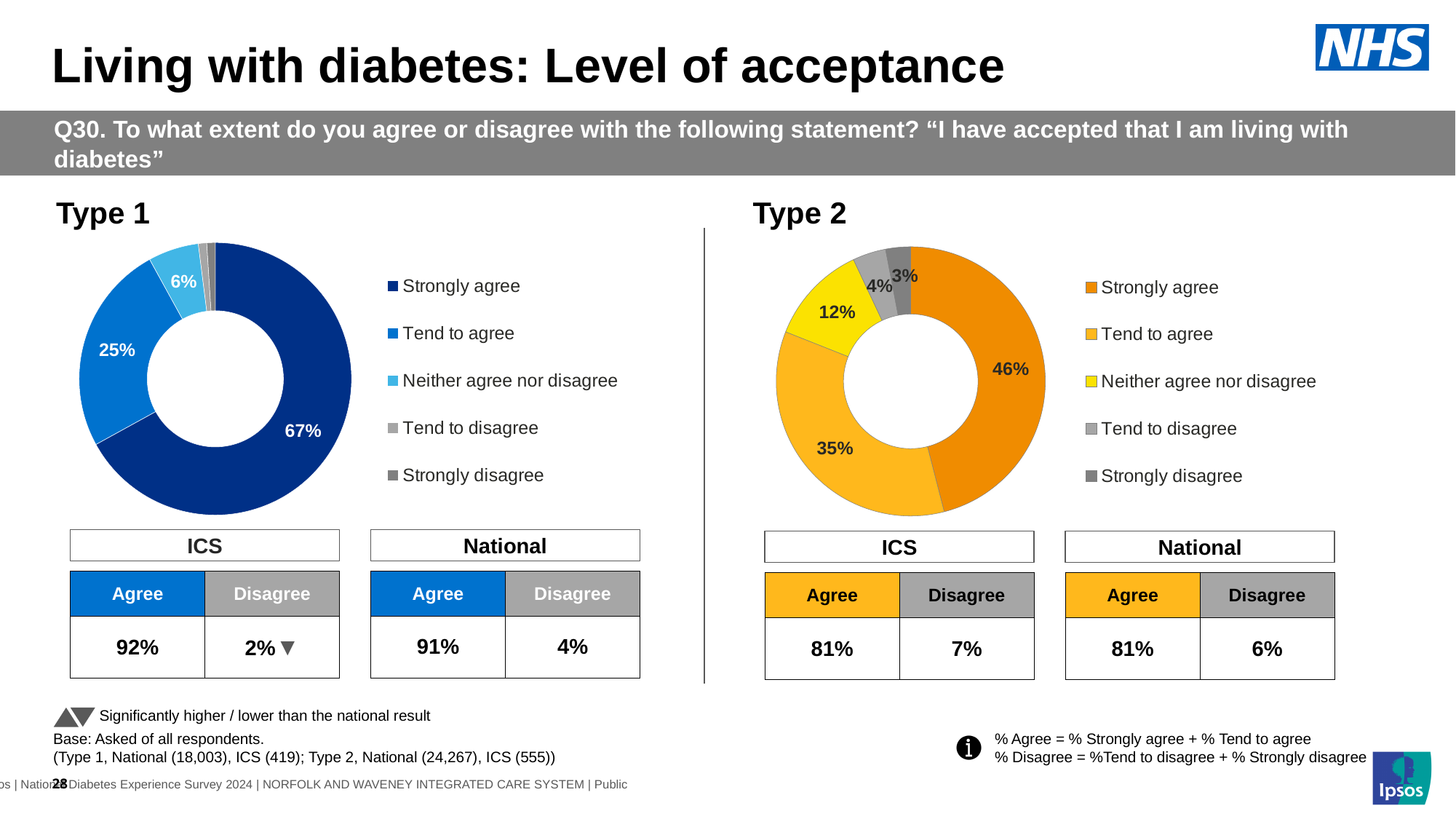
In the Type 1 chart, what is the difference between the Strongly agree and Tend to agree shares? 42 percentage points In the Type 1 chart, what colour represents Strongly agree? Dark blue In the Type 2 chart, which response category has the smallest share? Strongly disagree How many response categories does the legend of the Type 2 chart list? 5 In the Type 2 chart, what percentage of respondents neither agree nor disagree? 12% In the Type 2 chart, which response category has the largest share? Strongly agree In the Type 1 chart, what percentage of respondents tend to agree? 25% In the Type 2 chart, what is the difference between the Strongly agree and Tend to agree shares? 11 percentage points In the Type 2 chart, what percentage of respondents tend to disagree? 4% Which chart has the larger Strongly agree share, Type 1 or Type 2? Type 1 What kind of chart is used to show the Type 1 results? Doughnut chart In the Type 1 chart, what percentage of respondents strongly agree? 67%